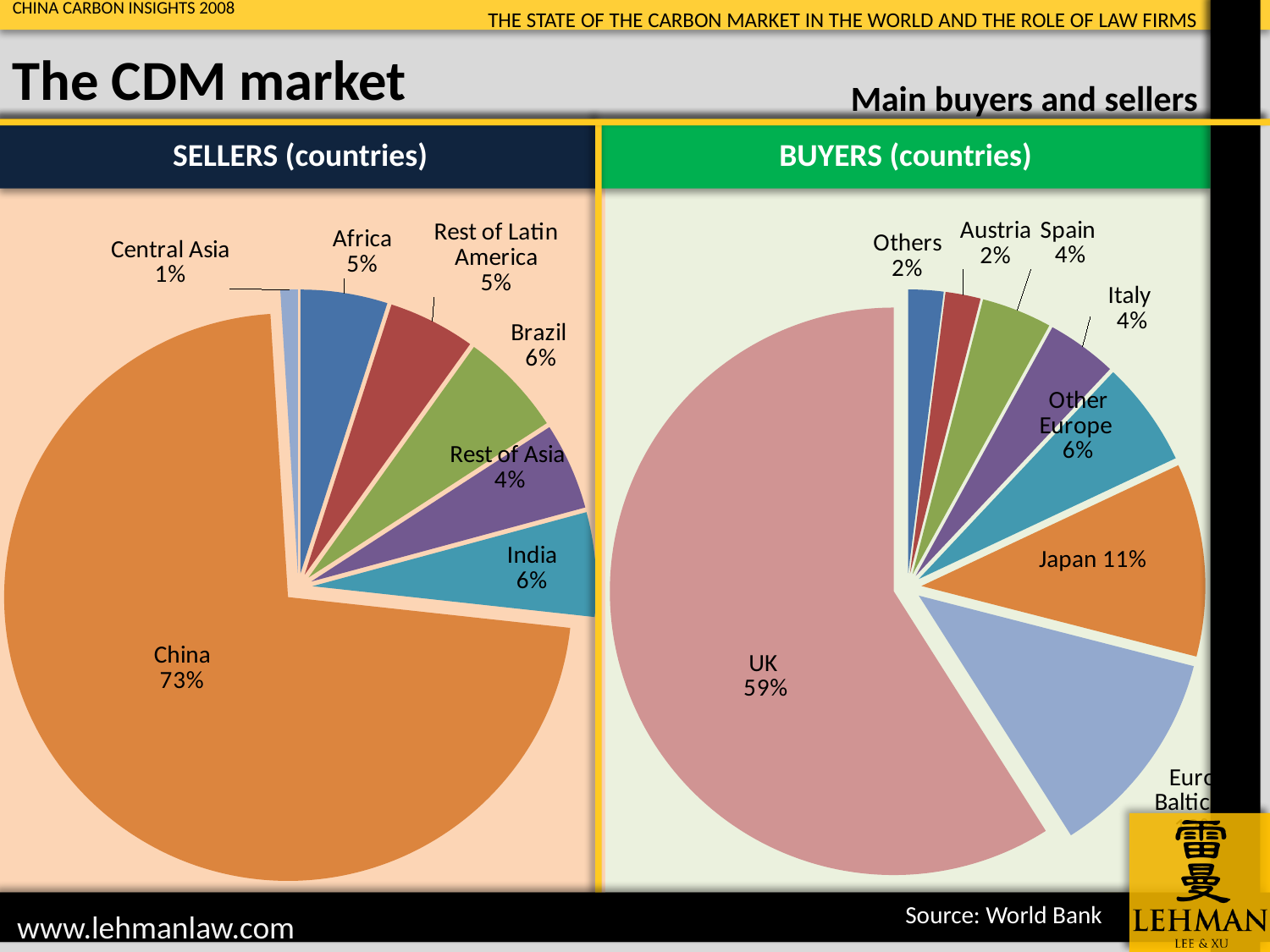
In the BUYERS (countries) pie chart, which country has the largest slice? UK In the SELLERS (countries) pie chart, what is the difference between China's share and India's share? 67 percentage points How many slices does the SELLERS (countries) pie chart have? 7 In the BUYERS (countries) pie chart, what share does the UK hold? 59% What kind of chart is the SELLERS (countries) chart? Pie chart In the SELLERS (countries) pie chart, what share does China hold? 73% In the SELLERS (countries) pie chart, which category has the smallest slice? Central Asia In the SELLERS (countries) pie chart, which country has the largest slice? China In the BUYERS (countries) pie chart, which has the larger share, Italy or Austria? Italy In the BUYERS (countries) pie chart, what share does Japan hold? 11% In the BUYERS (countries) pie chart, what is the difference between Japan's share and Other Europe's share? 5 percentage points What is the title of the pie chart on the left side of the slide? SELLERS (countries)